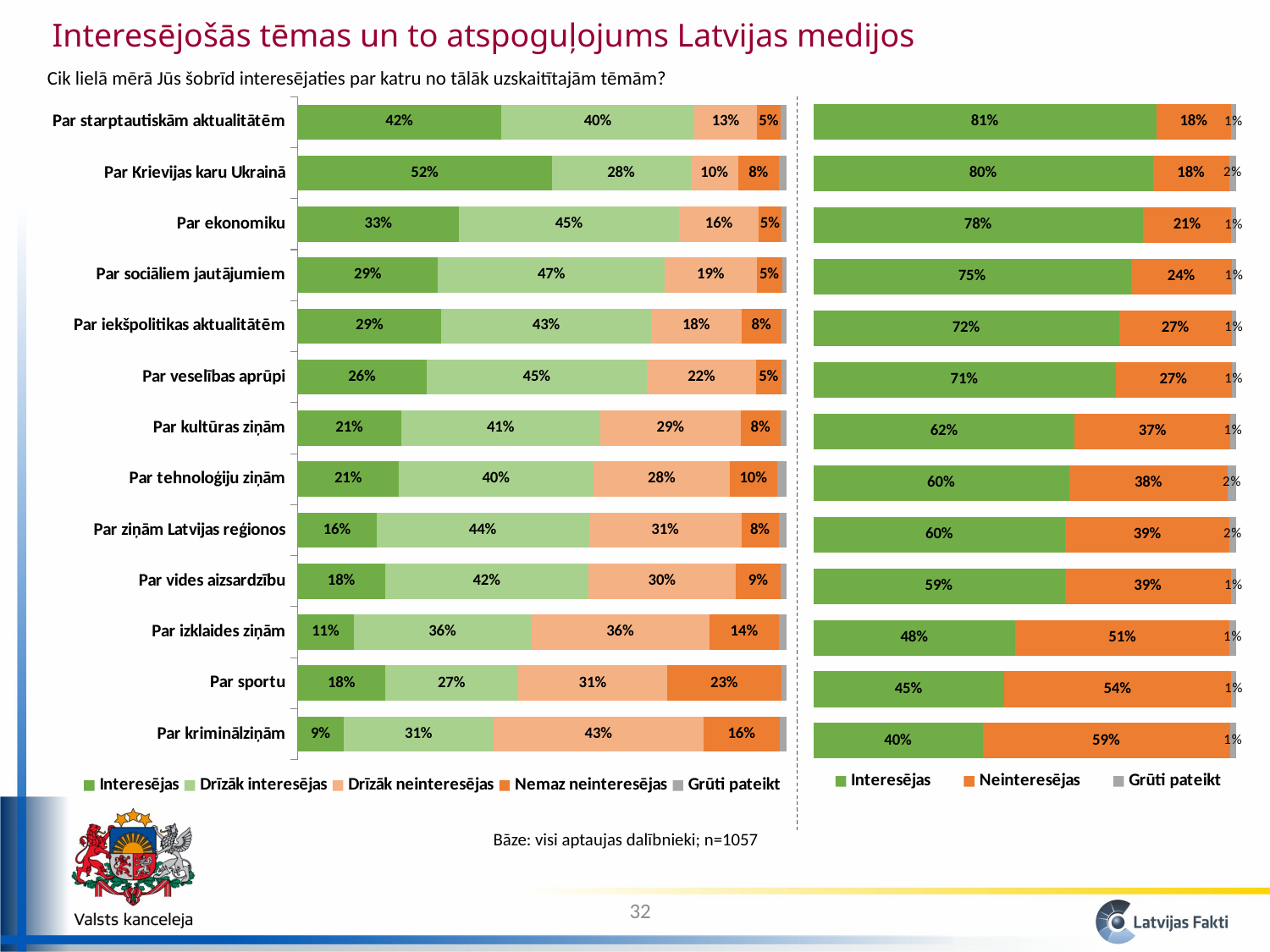
In the right chart, what is the 'Neinteresējas' value for 'Par sportu'? 54% How many topics (categories) are shown in the left chart? 13 In the left chart, which has the larger 'Nemaz neinteresējas' value: 'Par sportu' or 'Par izklaides ziņām'? Par sportu In the right chart, what is the total of the stacked bar for 'Par ekonomiku'? 100% In the right chart, what is the difference in 'Interesējas' between 'Par starptautiskām aktualitātēm' and 'Par kriminālziņām'? 41 percentage points In the left chart, what is the 'Interesējas' value for 'Par Krievijas karu Ukrainā'? 52% How many series does the legend of the left chart list? 5 In the left chart, which topic has the lowest 'Interesējas' value? Par kriminālziņām What are the three legend entries of the right chart? Interesējas, Neinteresējas, Grūti pateikt In the right chart, which topic has the highest 'Interesējas' value? Par starptautiskām aktualitātēm What kind of chart is the right chart? Stacked bar chart In the left chart, what is the 'Drīzāk neinteresējas' value for 'Par kriminālziņām'? 43%